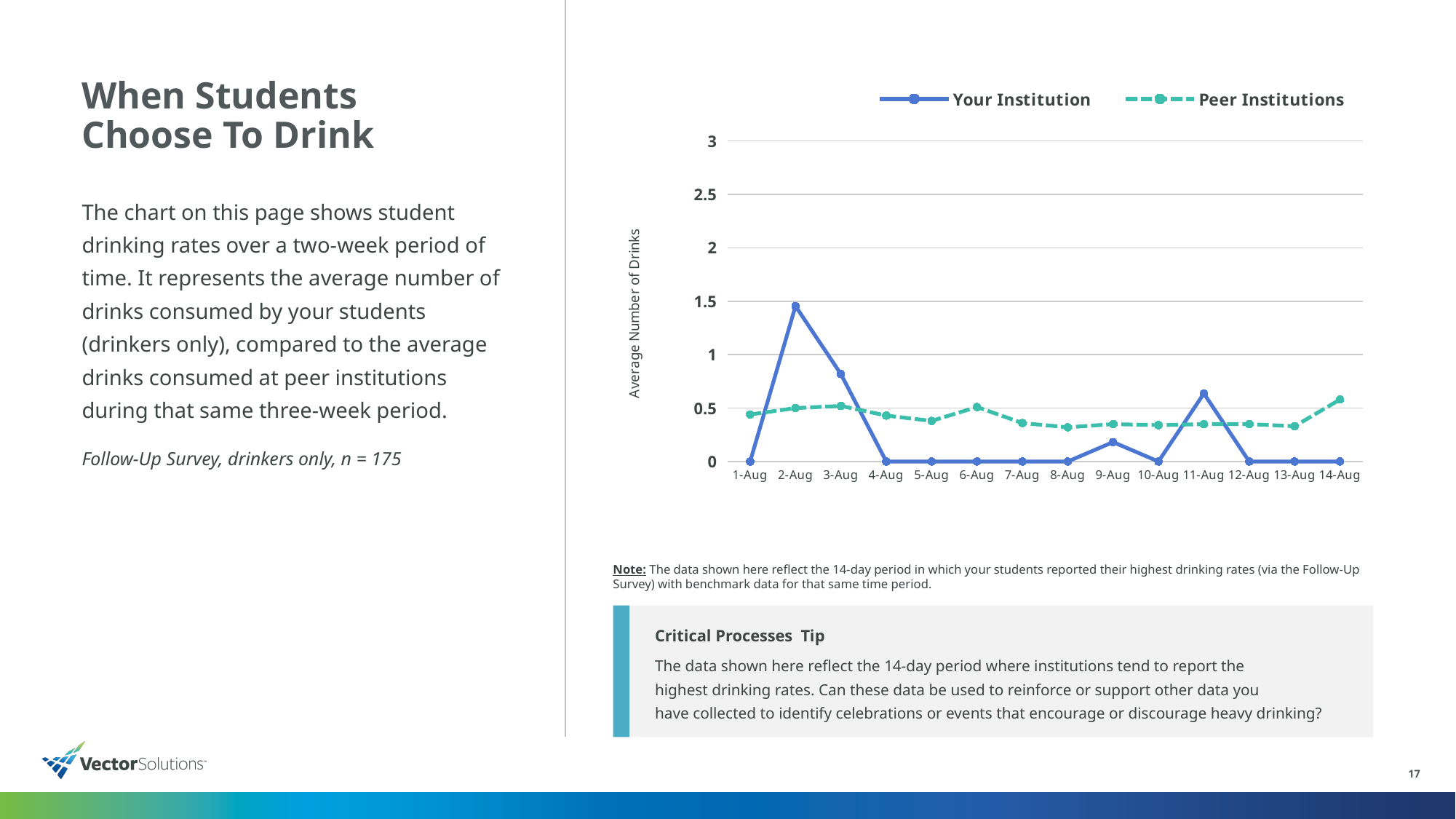
Is the value for Peer Institutions on 8-Aug greater or less than 0.5? less On which date does the Your Institution series reach its highest value? 2-Aug How many series does the chart legend list? 2 What is the title of the chart's vertical axis? Average Number of Drinks How many dates are plotted along the x axis of the chart? 14 Is the value for Your Institution on 2-Aug greater or less than 1? greater Is the value for Your Institution on 3-Aug greater or less than 0.5? greater What kind of chart is shown on the slide? line chart What is the value for Your Institution on 4-Aug? 0 On 2-Aug, which series has the larger value, Your Institution or Peer Institutions? Your Institution On 8-Aug, which series has the larger value, Your Institution or Peer Institutions? Peer Institutions What is the value for Your Institution on 1-Aug? 0